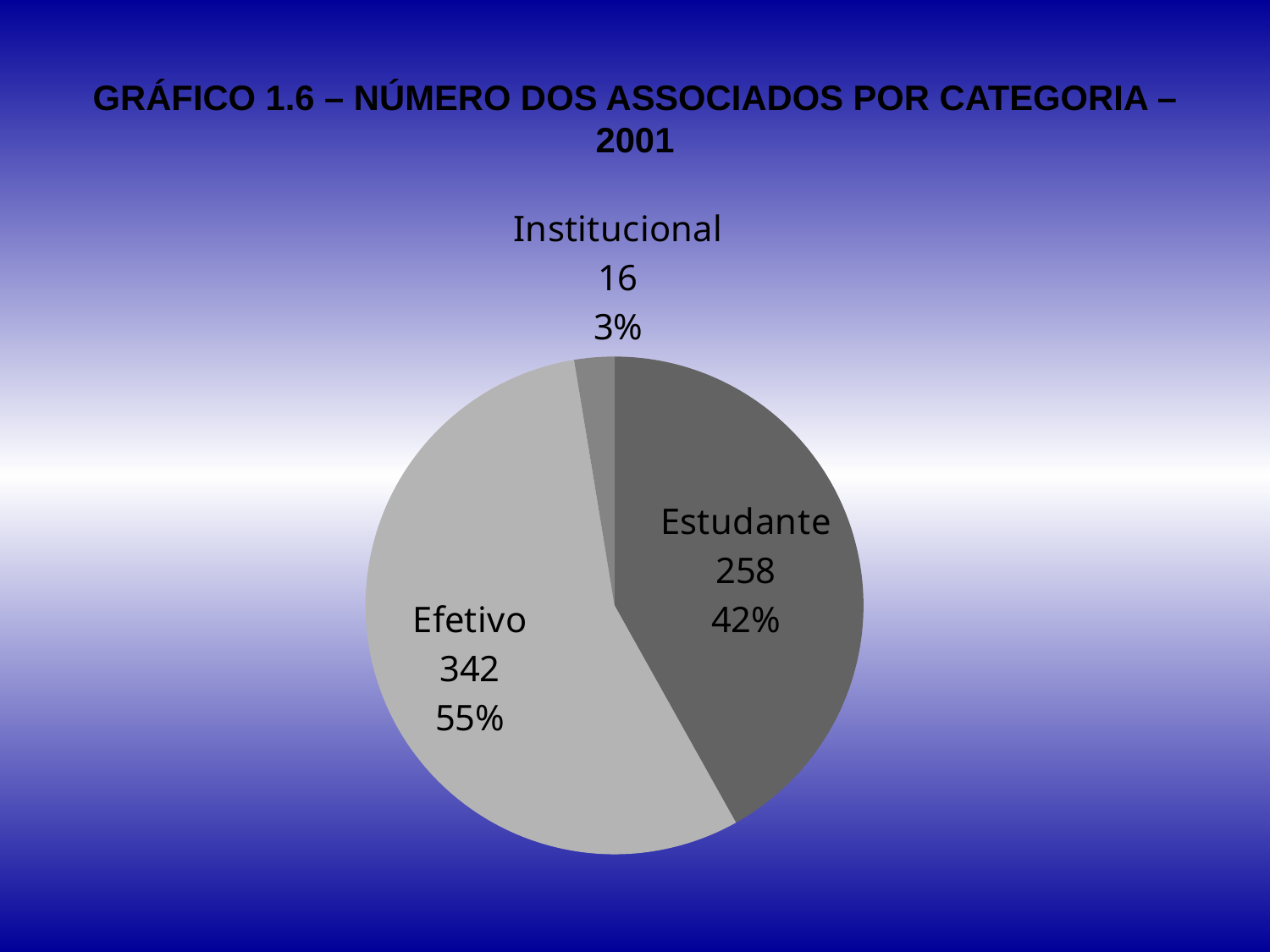
What share of the pie does the Institucional slice represent? 3% What is the number of associates in the Estudante category? 258 How many categories does the pie chart show? 3 What is the difference between the number of Efetivo and Estudante associates? 84 What share of the pie does the Estudante slice represent? 42% What is the title of the chart? GRÁFICO 1.6 – NÚMERO DOS ASSOCIADOS POR CATEGORIA – 2001 What is the number of associates in the Institucional category? 16 Which category has more associates, Estudante or Institucional? Estudante What type of chart is shown on the slide? pie chart What is the number of associates in the Efetivo category? 342 Which category has the smallest number of associates? Institucional Which category has the largest number of associates? Efetivo